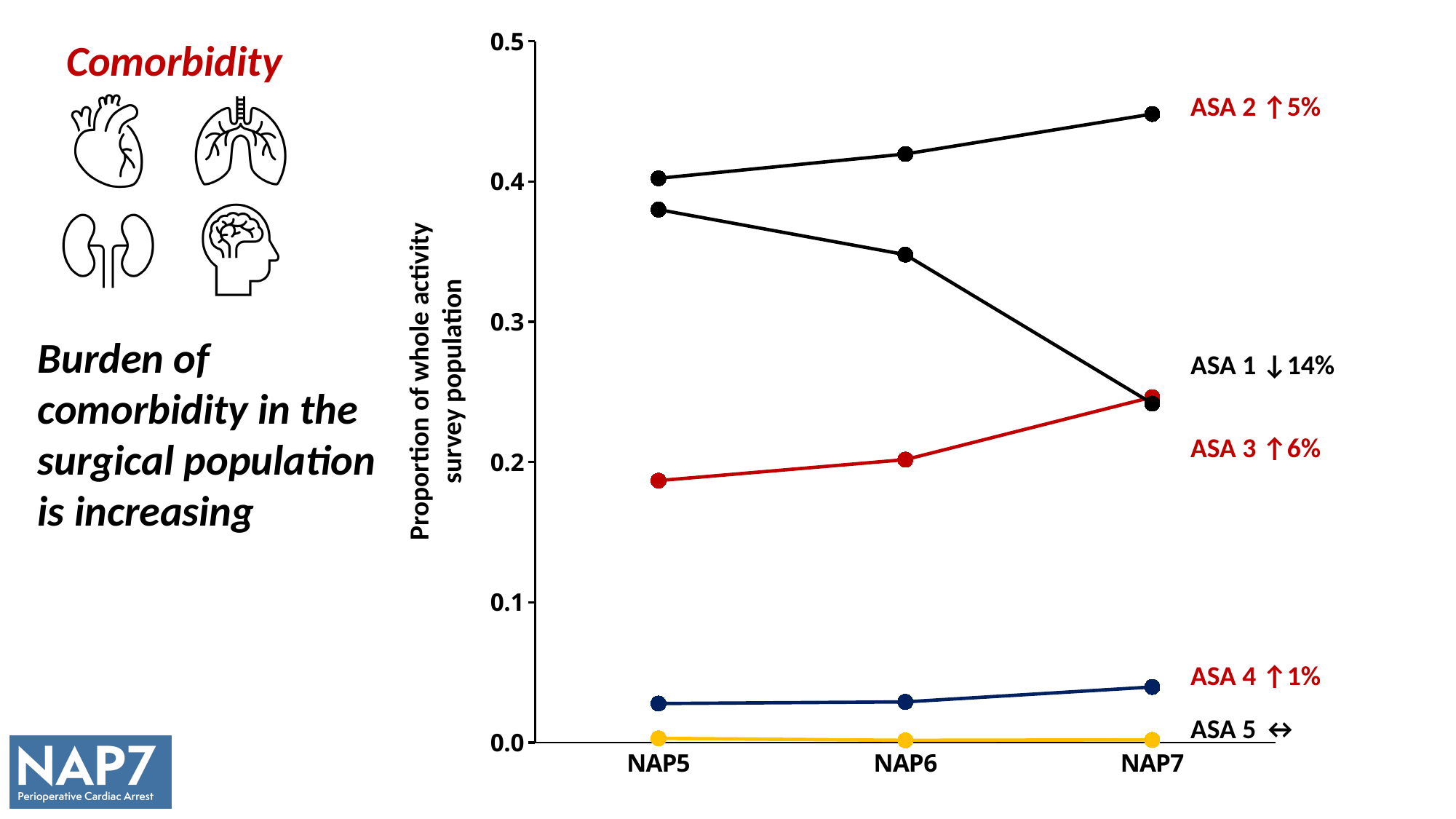
Does the ASA 3 line rise or fall from NAP5 to NAP7? rise How many ASA series are plotted on the chart? 5 Is the value for ASA 3 at NAP5 greater or less than 0.2? less Which ASA series has the lowest value at NAP7? ASA 5 Is the value for ASA 2 at NAP7 greater or less than 0.4? greater Which ASA series has the highest value at NAP7? ASA 2 How many points are on the x axis of the chart? 3 At NAP6, which is larger: the value for ASA 1 or the value for ASA 3? ASA 1 Is the value for ASA 4 at NAP7 greater or less than 0.1? less Does the ASA 1 line rise or fall from NAP5 to NAP7? fall Does the ASA 2 line rise or fall from NAP5 to NAP7? rise What kind of chart is shown on the slide? line chart